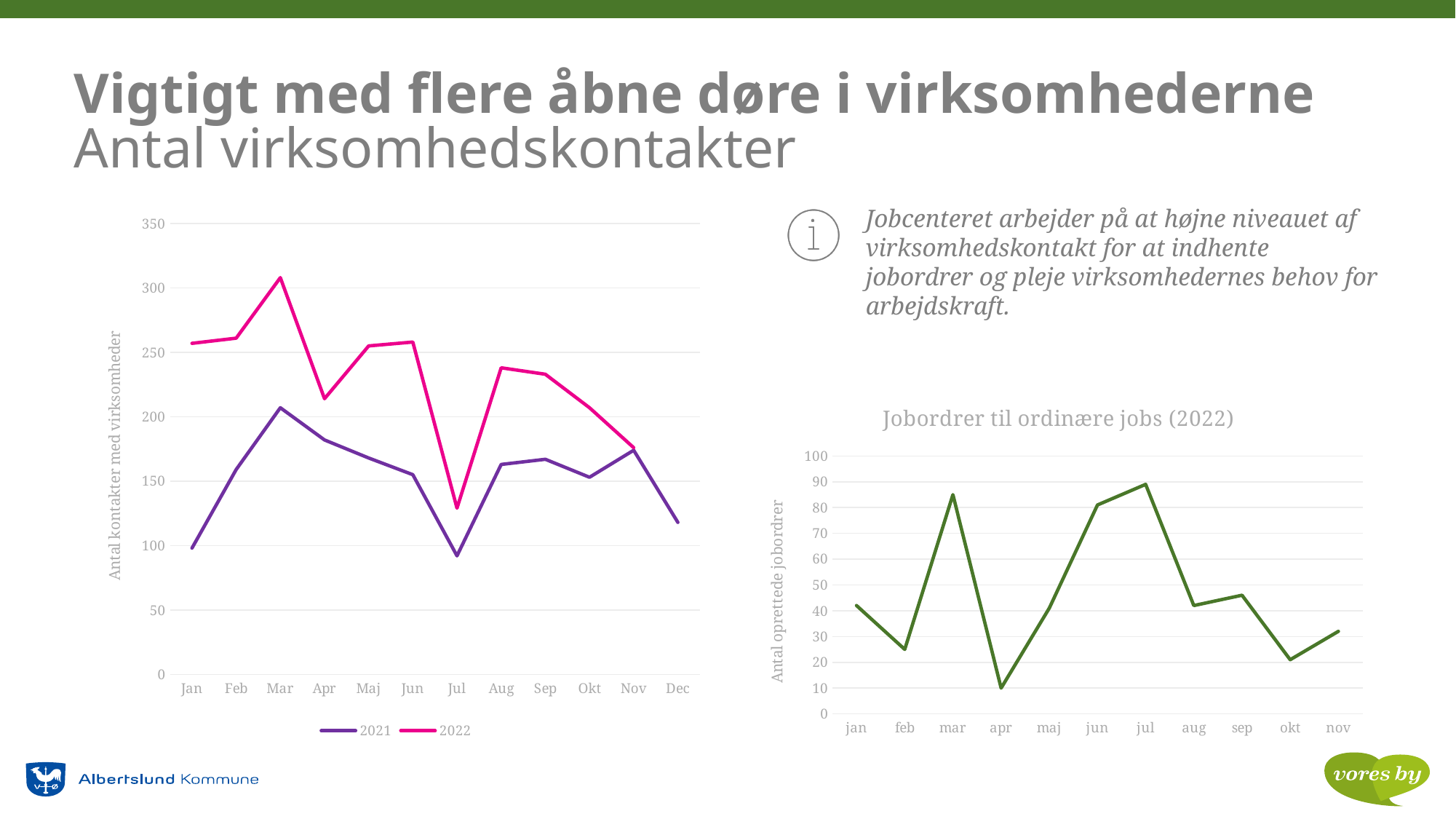
In the chart 'Jobordrer til ordinære jobs (2022)', is the value for mar greater or less than 80? greater How many series does the legend of the left chart list? 2 In the left chart, which series has the larger value in Jan, 2021 or 2022? 2022 In the chart 'Jobordrer til ordinære jobs (2022)', which month has the highest value? jul In the chart 'Jobordrer til ordinære jobs (2022)', which month has the lowest value? apr How many months are shown on the x axis of the left chart? 12 In the left chart, is the 2022 value for Jul greater or less than 150? less In the left chart, in which month does the 2022 series reach its highest value? Mar In the left chart, is the 2022 value for Mar greater or less than 300? greater What kind of chart is the left chart on the slide? line chart In the left chart, in which month does the 2021 series reach its lowest value? Jul In the chart 'Jobordrer til ordinære jobs (2022)', how many months are plotted? 11